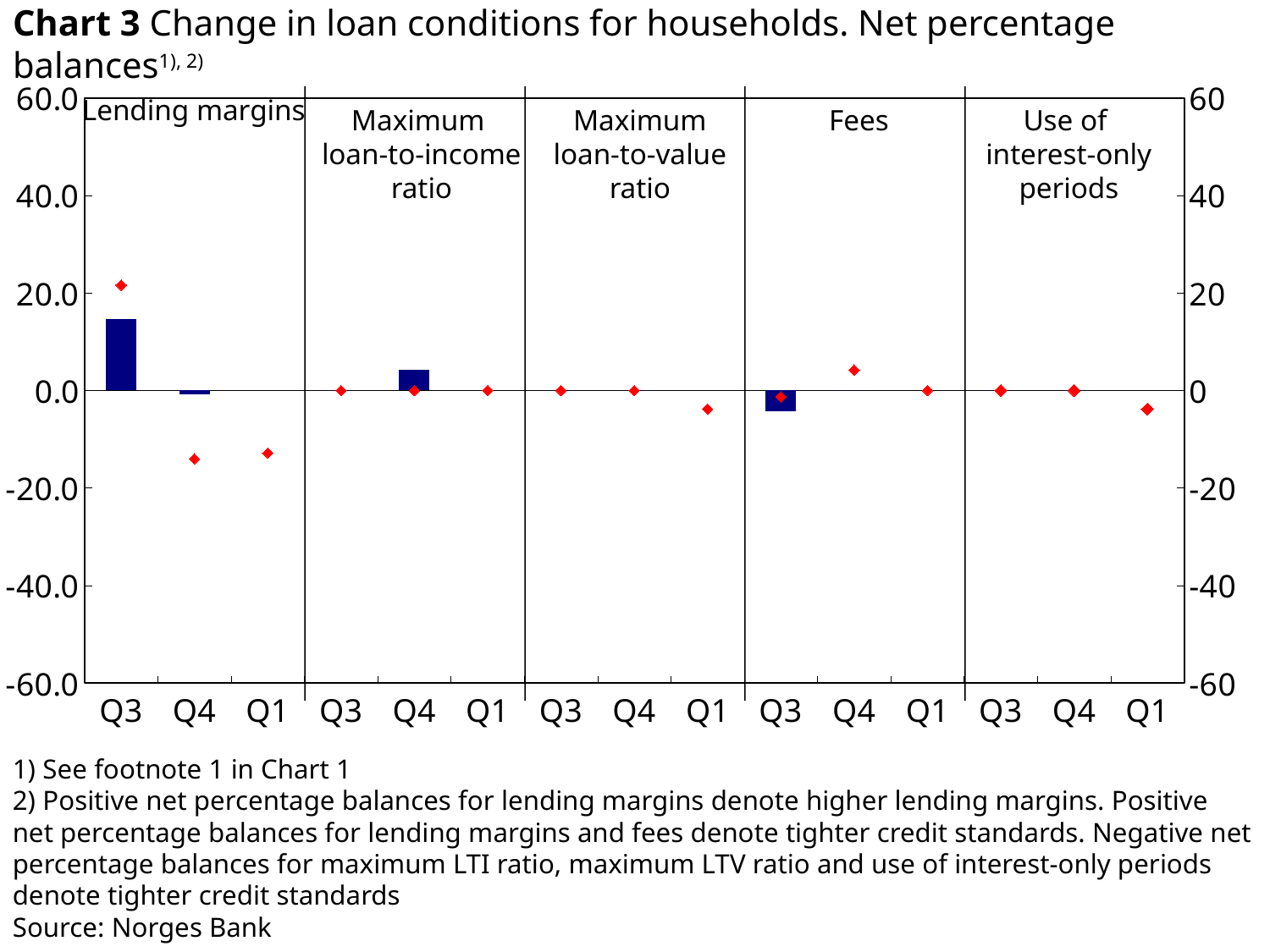
Is the Q3 bar in the Lending margins panel greater or less than 20? less What kind of chart is Chart 3? combination bar and line chart (bars with red diamond markers) In the Lending margins panel, do the red markers rise or fall from Q3 to Q4? fall How many quarters are shown on the x axis within each panel of Chart 3? 3 What is the title of Chart 3? Change in loan conditions for households. Net percentage balances What is the source given for Chart 3? Norges Bank Is the Q4 red marker in the Lending margins panel greater or less than -10? less Is the Q3 bar in the Fees panel greater or less than 0? less In which panel of Chart 3 is the tallest bar found? Lending margins Which is larger: the Q3 bar in the Lending margins panel or the Q4 bar in the Maximum loan-to-income ratio panel? Q3 bar in Lending margins How many loan-condition panels does Chart 3 contain? 5